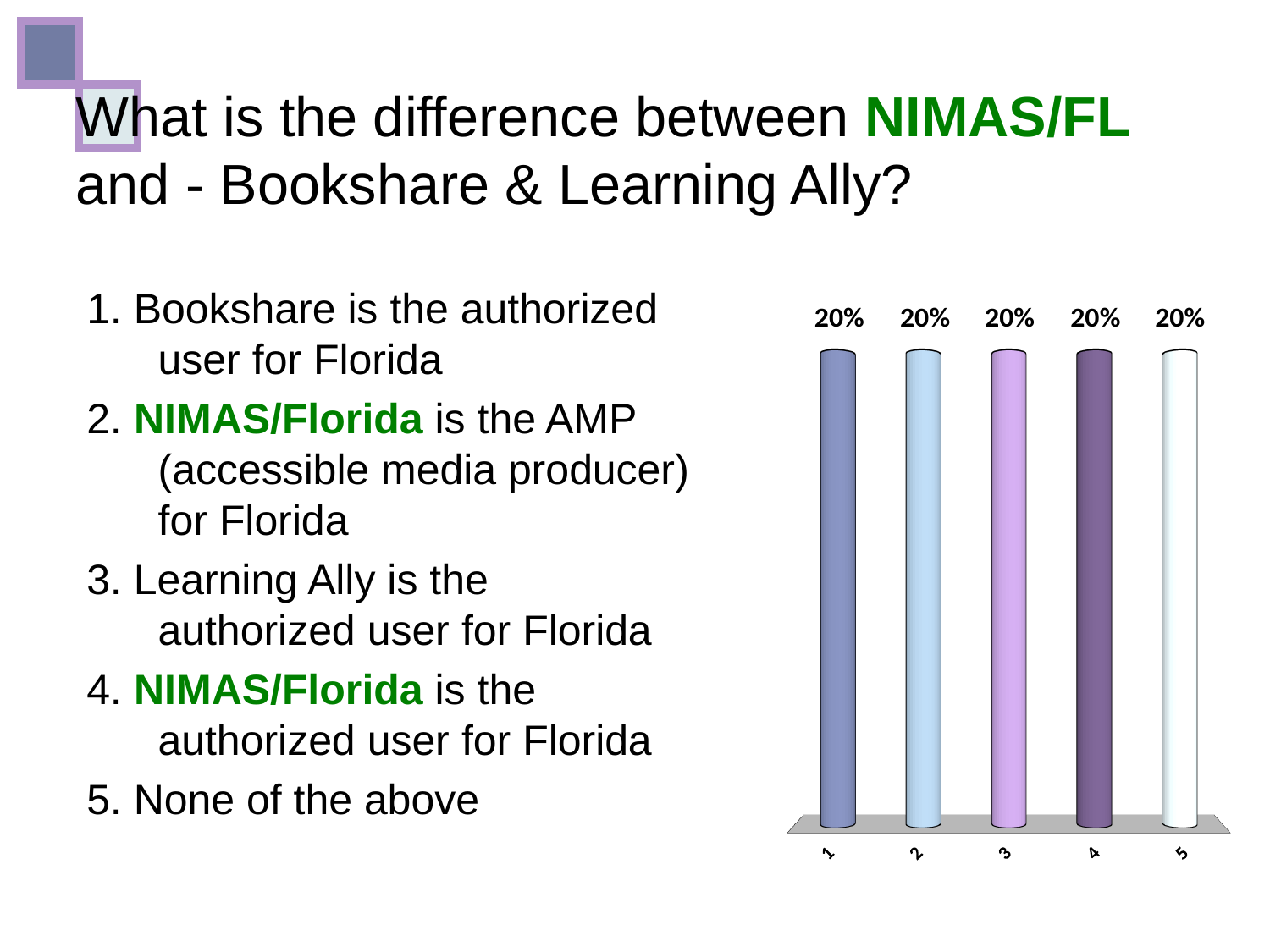
Do all five bars on the chart have the same value? yes What are the category labels along the x axis of the chart? 1, 2, 3, 4, 5 What is the value for category 4? 20% What is the value for category 5? 20% What is the value for category 1? 20% Do the values rise, fall, or stay the same across categories 1 to 5? stay the same How many categories are shown on the chart? 5 What kind of chart is shown on the slide? bar chart What is the difference between the values for category 2 and category 4? 0% What colour is the bar for category 3? light purple What is the value for category 3? 20%